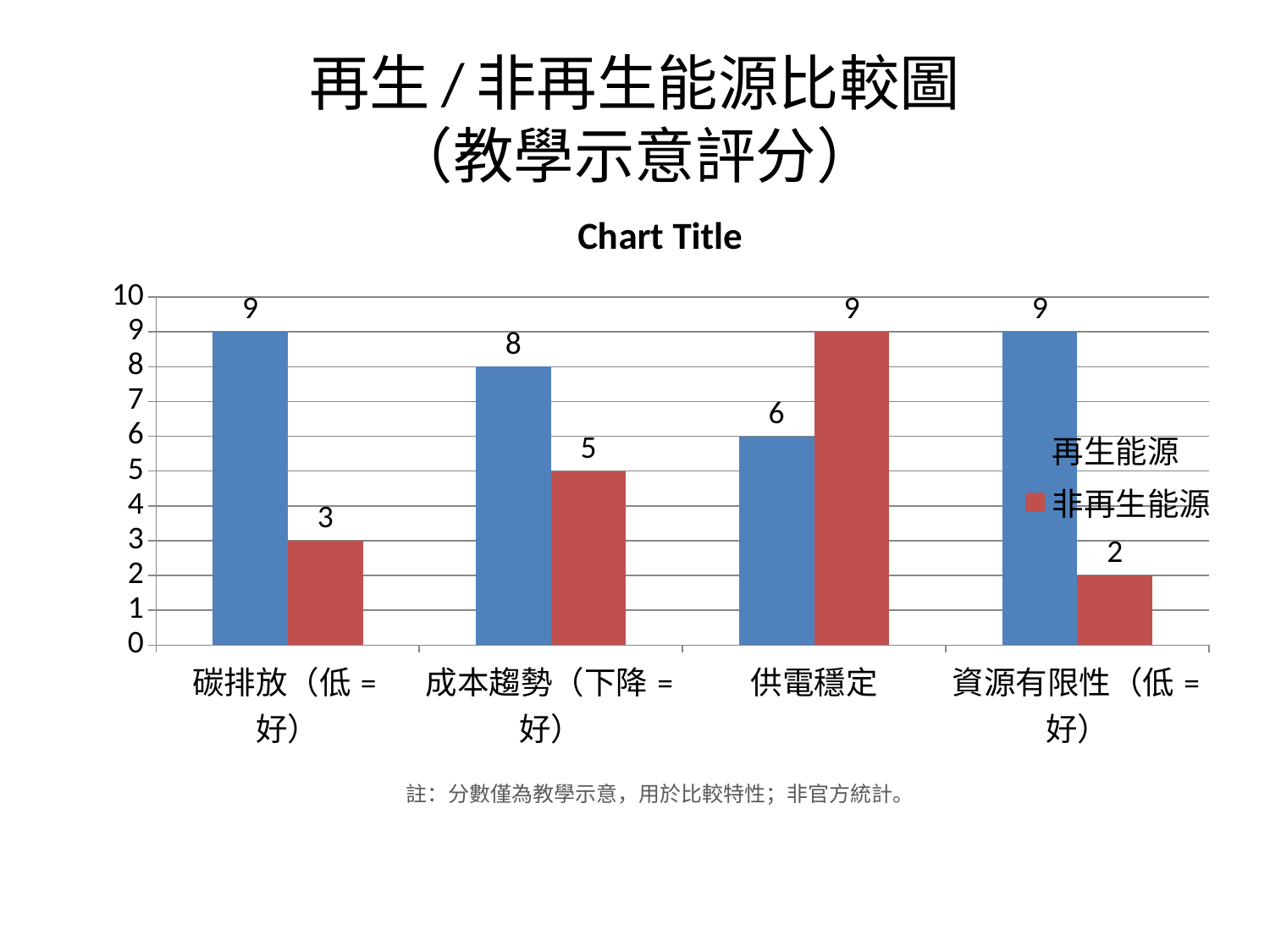
In which category does 非再生能源 have its highest value? 供電穩定 How many categories are shown on the x axis? 4 What kind of chart is shown on the slide? Bar chart In which category does 再生能源 have its lowest value? 供電穩定 What is the value for 非再生能源 in the 成本趨勢（下降 = 好） category? 5 What is the value for 非再生能源 in the 資源有限性（低 = 好） category? 2 How many series does the legend list? 2 What is the value for 非再生能源 in the 供電穩定 category? 9 In the 供電穩定 category, which series has the larger value, 再生能源 or 非再生能源? 非再生能源 What is the value for 再生能源 in the 碳排放（低 = 好） category? 9 What is the title shown above the chart? Chart Title What is the difference between the 再生能源 and 非再生能源 values in the 碳排放（低 = 好） category? 6